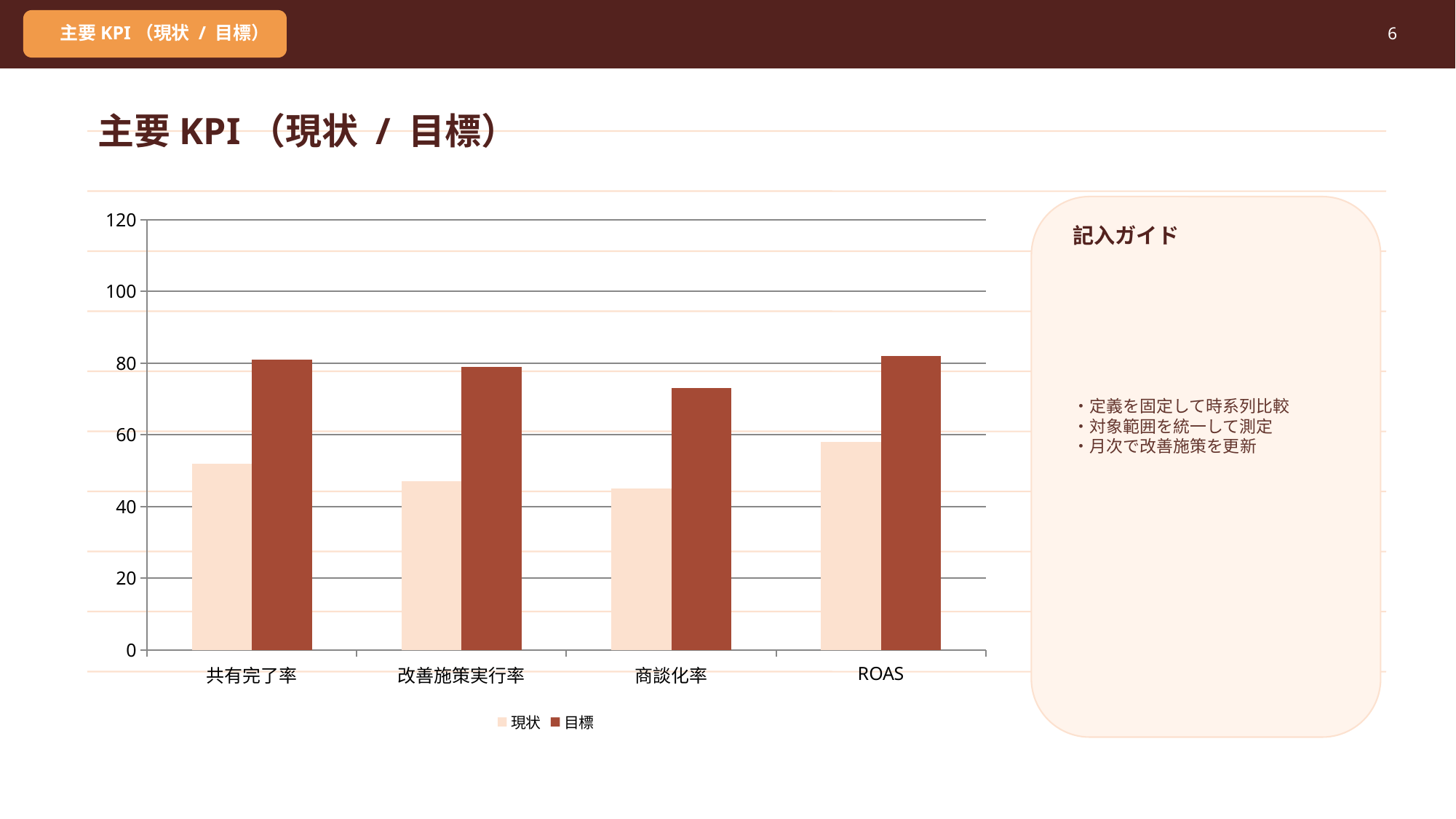
Which is larger, the 現状 value for ROAS or the 現状 value for 共有完了率? ROAS Is the 目標 value for 商談化率 greater or less than 60? greater Which category has the lowest 目標 value? 商談化率 What are the two series named in the chart legend? 現状 and 目標 What is the maximum value shown on the chart's vertical axis? 120 Is the 現状 value for 共有完了率 greater or less than 40? greater How many categories are shown on the x axis of the chart? 4 How many series does the chart legend list? 2 Is the 現状 value for 商談化率 greater or less than 60? less For 共有完了率, which is larger, the 現状 value or the 目標 value? 目標 What kind of chart is shown on the slide? bar chart Which category has the highest 現状 value? ROAS